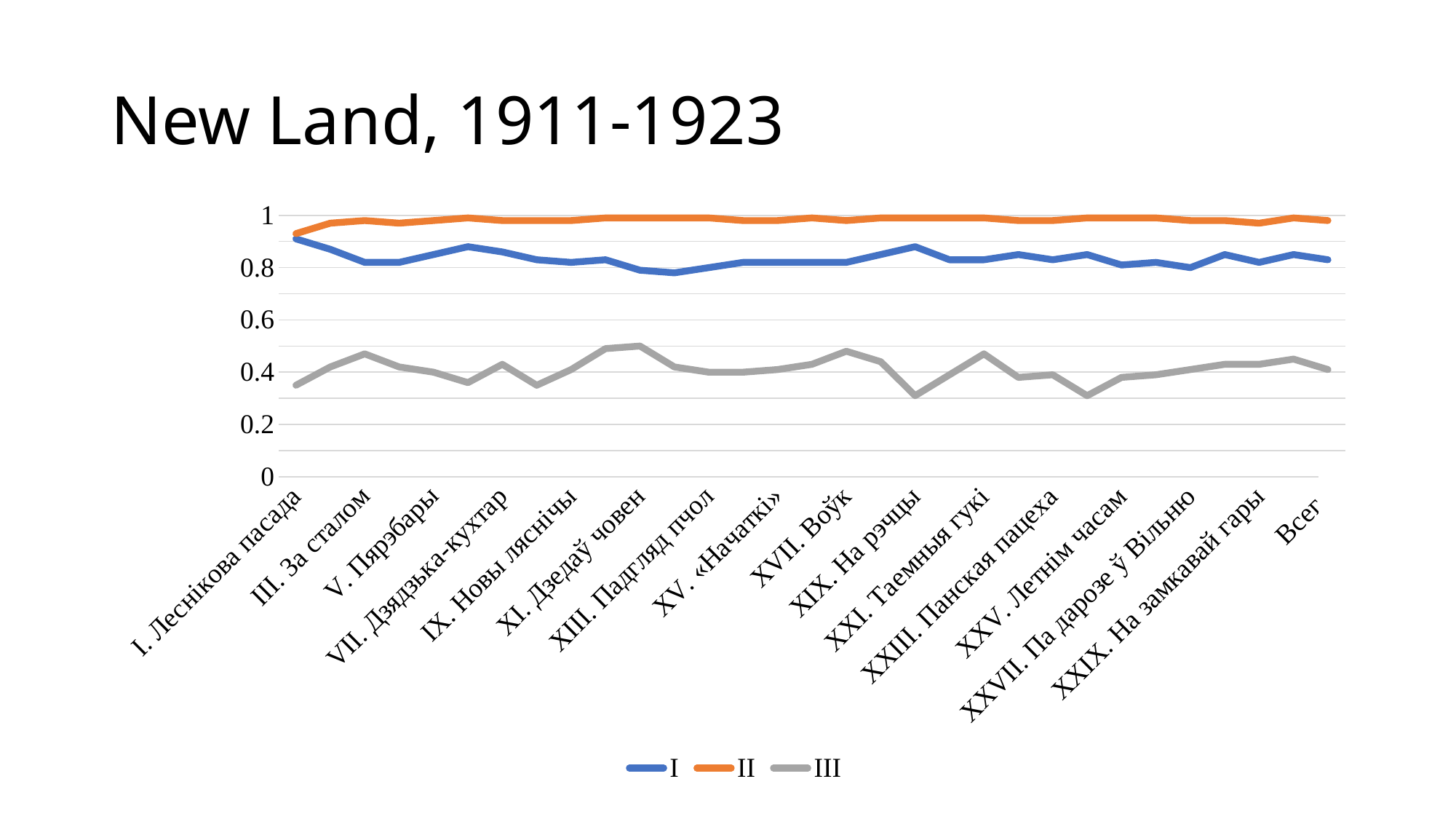
How many series does the legend list? 3 Is the value of series III for XIX. На рэчцы greater or less than 0.4? less Is the value of series III for XI. Дзедаў човен greater or less than 0.4? greater Which series has the highest values across all categories? II Which colour is used for series II in the chart? orange Is the value of series I for I. Леснікова пасада greater or less than 0.8? greater For III. За сталом, which is larger: the value of series I or series II? II Does series III rise or fall from XVII. Воўк to XIX. На рэчцы? fall Which series has the lowest values across all categories? III What kind of chart is shown on the slide? line chart What is the title of the chart? New Land, 1911-1923